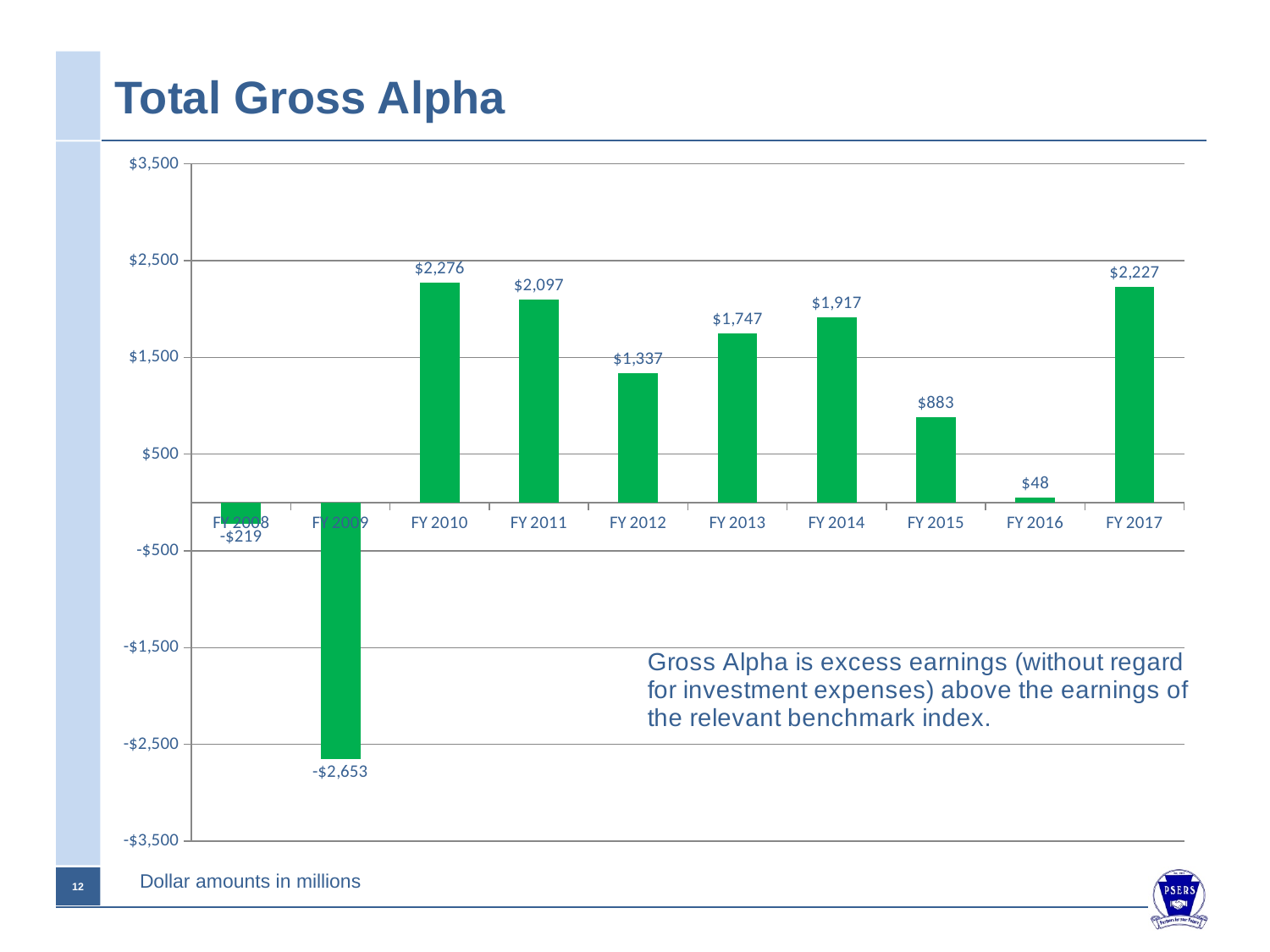
What is the Total Gross Alpha value for FY 2016? $48 Is the Total Gross Alpha value for FY 2015 greater or less than $500? greater What is the Total Gross Alpha value for FY 2010? $2,276 What is the difference between the Total Gross Alpha for FY 2010 and FY 2017? $49 What kind of chart is shown on the slide? Bar chart What is the title of the chart on the slide? Total Gross Alpha What is the Total Gross Alpha value for FY 2009? -$2,653 How many fiscal years are shown in the chart? 10 Which fiscal year has the lowest Total Gross Alpha? FY 2009 What is the Total Gross Alpha value for FY 2014? $1,917 Which fiscal year has the highest Total Gross Alpha? FY 2010 Which is larger, the Total Gross Alpha for FY 2013 or FY 2014? FY 2014